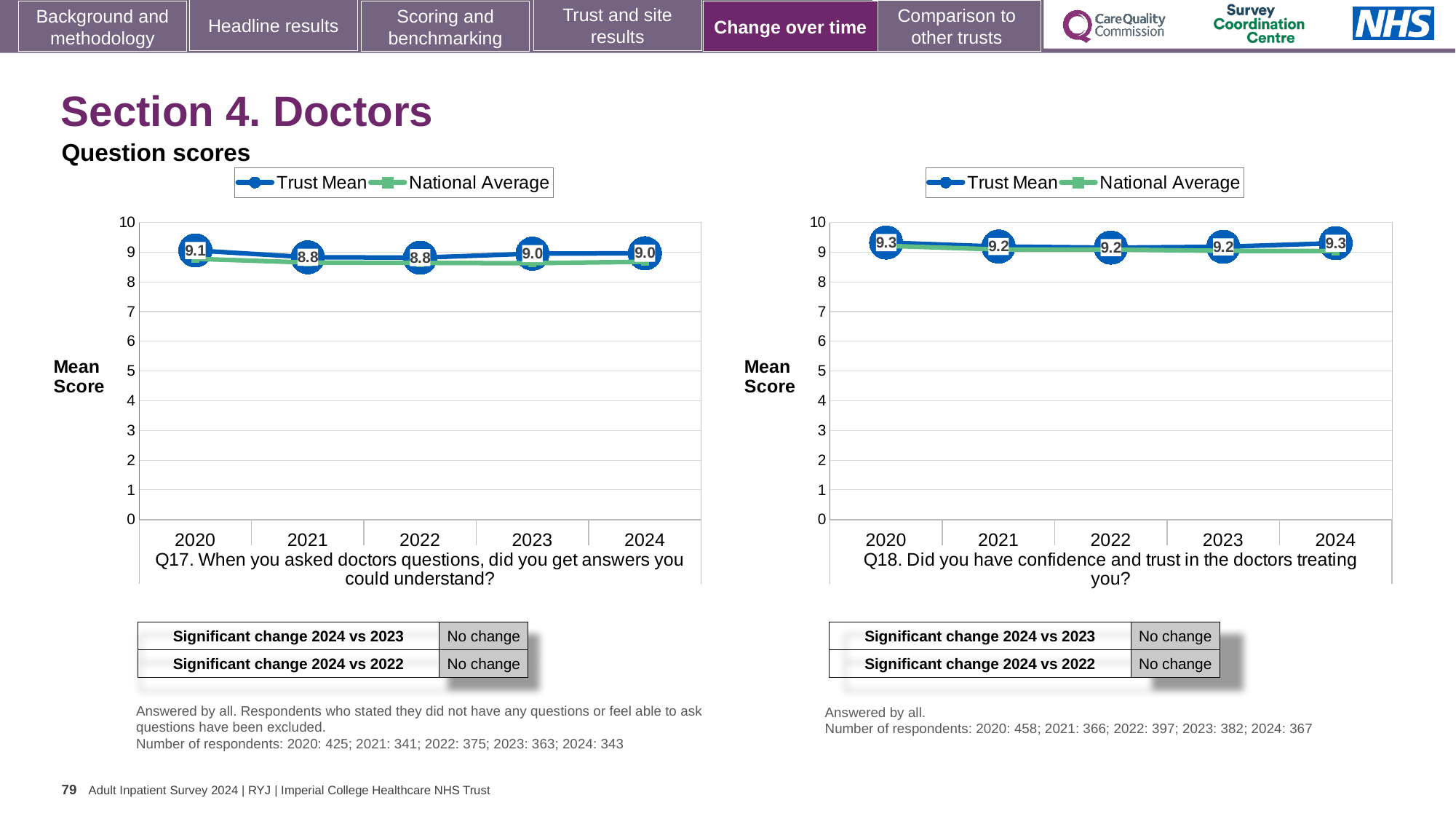
What are the two series named in the legend of the Q17 chart? Trust Mean and National Average In the Q18 chart, what is the Trust Mean score for 2024? 9.3 In the Q17 chart, what is the Trust Mean score for 2020? 9.1 In the Q17 chart, how many years are plotted on the x axis? 5 In the Q18 chart, is the Trust Mean score for 2022 greater or less than 8? greater What kind of chart is the Q17 chart? Line chart How many series does the legend of the Q18 chart list? 2 In the Q17 chart, what is the difference between the Trust Mean score in 2020 and in 2021? 0.3 In the Q17 chart, what is the Trust Mean score for 2024? 9.0 In the Q18 chart, what is the Trust Mean score for 2021? 9.2 In the Q17 chart, is the Trust Mean score in 2024 higher or lower than in 2021? Higher In the Q17 chart, which year has the highest Trust Mean score? 2020